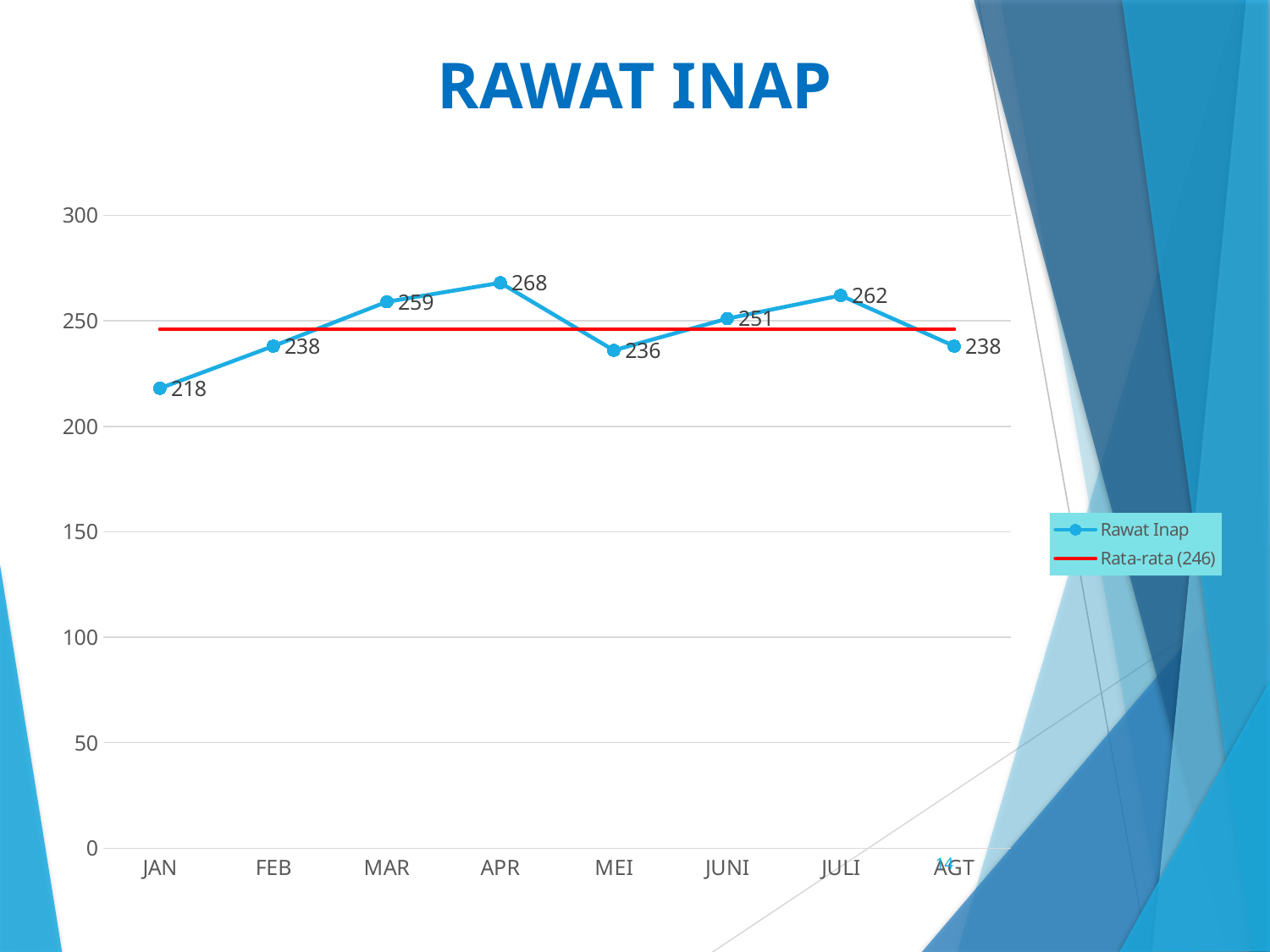
Is the Rawat Inap value for MEI greater or less than 250? less What is the Rawat Inap value for JULI? 262 How many months are plotted on the x axis? 8 Which is larger, the Rawat Inap value for MAR or for JUNI? MAR What is the Rawat Inap value for JAN? 218 What is the difference between the Rawat Inap values for APR and JAN? 50 What is the Rawat Inap value for APR? 268 Which month has the highest Rawat Inap value? APR What value does the legend give for the Rata-rata line? 246 Which month has the lowest Rawat Inap value? JAN How many series does the legend list? 2 What kind of chart is shown on the slide? line chart